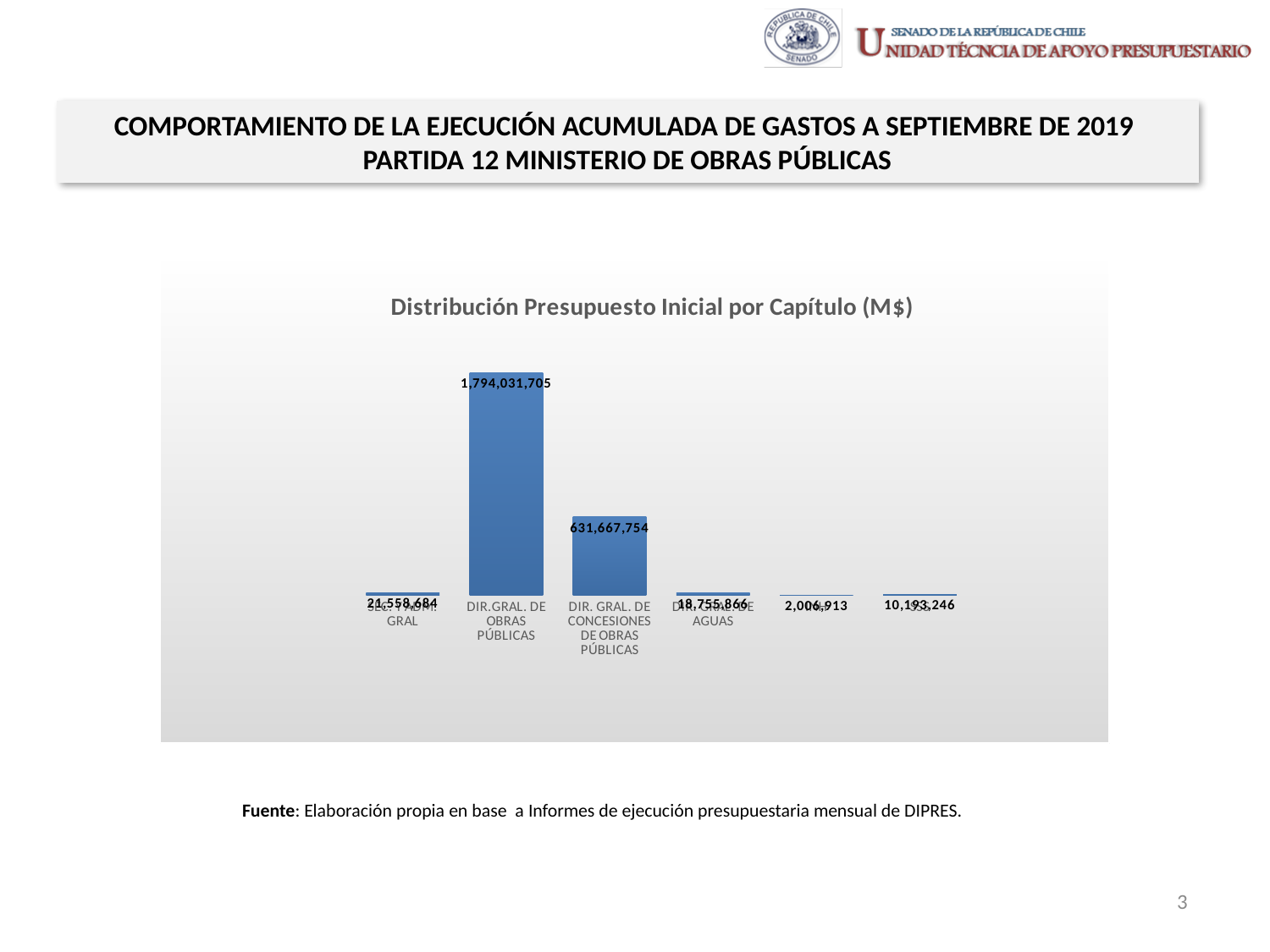
How many bars are shown in the chart? 6 Which is larger, the value for DIR. GRAL. DE CONCESIONES DE OBRAS PÚBLICAS or the value for DIR. GRAL. DE AGUAS? DIR. GRAL. DE CONCESIONES DE OBRAS PÚBLICAS What is the value for SEC. Y ADM. GRAL? 21,558,684 What is the value for DIR.GRAL. DE OBRAS PÚBLICAS in the chart? 1,794,031,705 What is the title of the chart? Distribución Presupuesto Inicial por Capítulo (M$) What kind of chart is shown on the slide? Bar chart Which category has the highest value in the chart? DIR.GRAL. DE OBRAS PÚBLICAS What is the difference between the values for DIR.GRAL. DE OBRAS PÚBLICAS and DIR. GRAL. DE CONCESIONES DE OBRAS PÚBLICAS? 1,162,363,951 What is the smallest value labelled on the chart? 2,006,913 What is the difference between the values for SEC. Y ADM. GRAL and DIR. GRAL. DE AGUAS? 2,802,818 What is the value for DIR. GRAL. DE AGUAS? 18,755,866 What is the value for DIR. GRAL. DE CONCESIONES DE OBRAS PÚBLICAS? 631,667,754